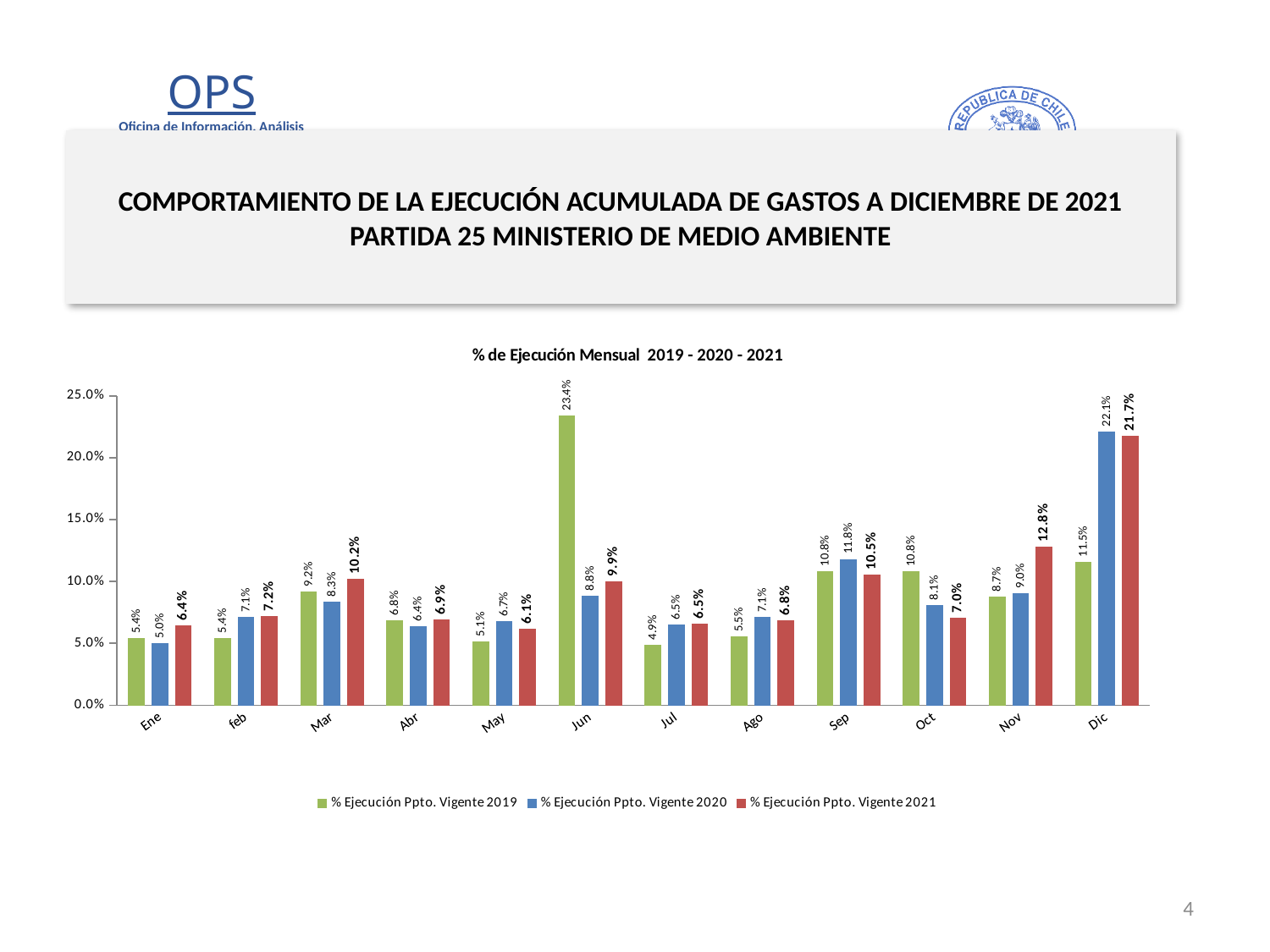
What is the value for Dic in the % Ejecución Ppto. Vigente 2020 series? 22.1% Is the value for Sep in the 2020 series greater or less than 10.0%? greater Which is larger for Oct: the 2019 value or the 2021 value? 2019 How many series does the legend list? 3 Which month has the highest value in the % Ejecución Ppto. Vigente 2021 series? Dic Which month has the lowest value in the % Ejecución Ppto. Vigente 2019 series? Jul What kind of chart is shown on the slide? Bar chart What is the value for Jun in the % Ejecución Ppto. Vigente 2019 series? 23.4% What is the value for Nov in the % Ejecución Ppto. Vigente 2021 series? 12.8% How many months are shown on the x axis? 12 What is the value for Mar in the % Ejecución Ppto. Vigente 2021 series? 10.2% What is the difference between the 2019 and 2020 values for Jun? 14.6%